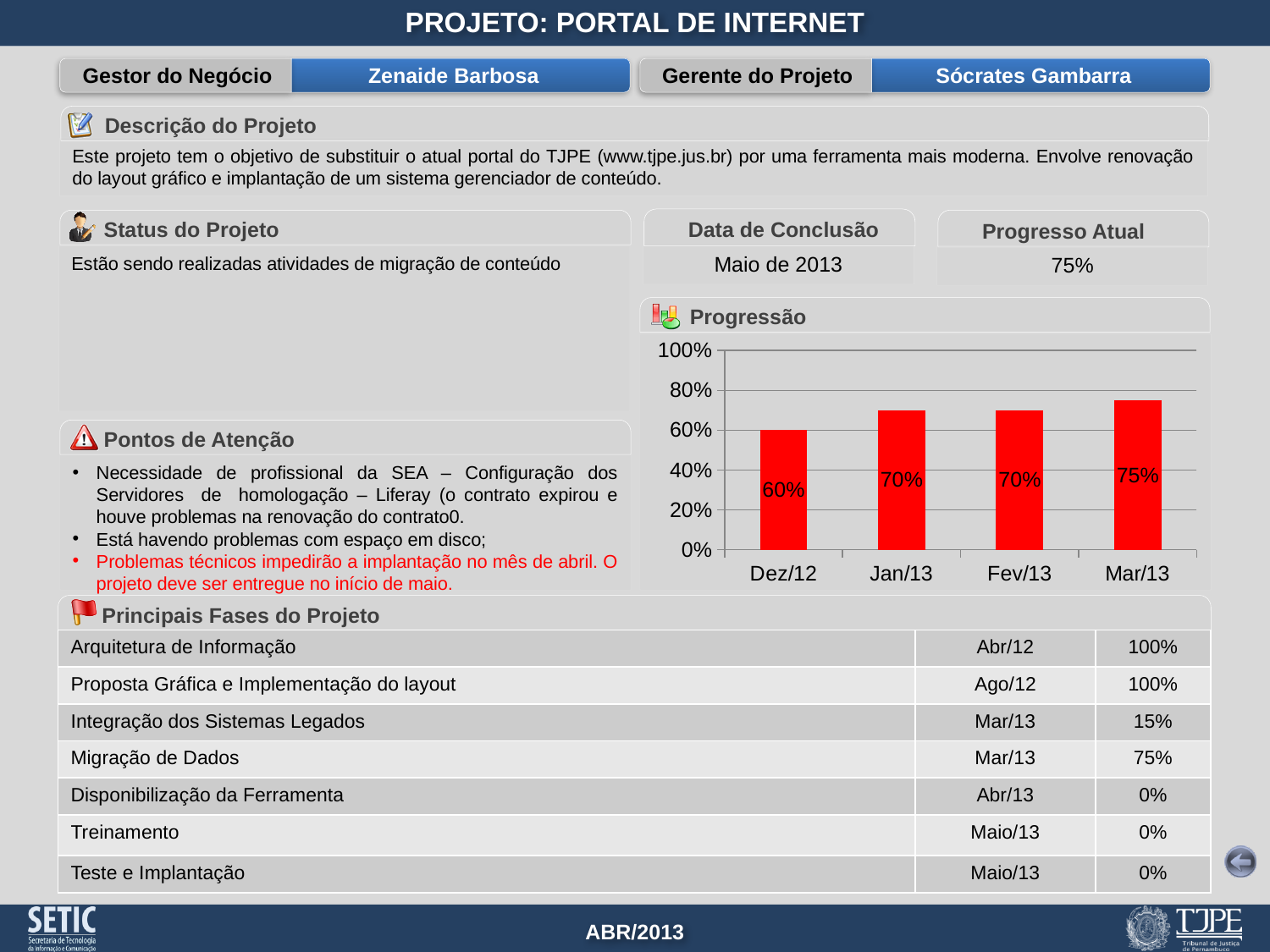
Which month has the highest value in the Progressão chart? Mar/13 Which is larger in the Progressão chart, the value for Dez/12 or the value for Fev/13? Fev/13 What is the value for Mar/13 in the Progressão chart? 75% What is the difference between the values for Mar/13 and Dez/12 in the Progressão chart? 15% What colour are the bars in the Progressão chart? red How many months are shown on the x axis of the Progressão chart? 4 Which month has the lowest value in the Progressão chart? Dez/12 Is the value for Mar/13 in the Progressão chart greater or less than 80%? less What kind of chart is the Progressão chart? bar chart Do the values in the Progressão chart generally rise or fall from Dez/12 to Mar/13? rise What is the value for Jan/13 in the Progressão chart? 70% What is the value for Dez/12 in the Progressão chart? 60%